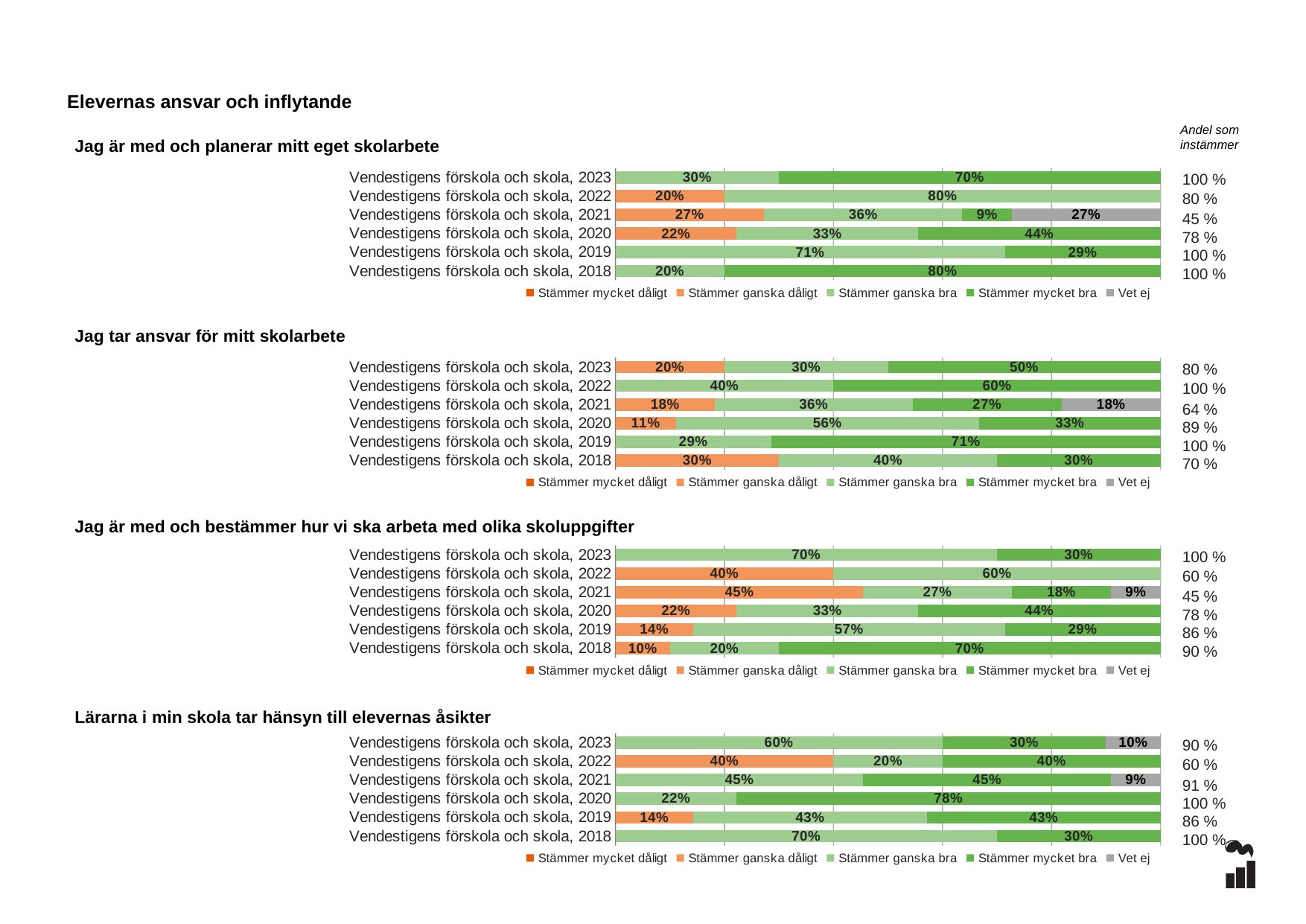
In the chart 'Jag är med och planerar mitt eget skolarbete', what is the 'Vet ej' value for Vendestigens förskola och skola, 2021? 27% In the chart 'Lärarna i min skola tar hänsyn till elevernas åsikter', what is the 'Andel som instämmer' for Vendestigens förskola och skola, 2021? 91 % In the chart 'Jag är med och bestämmer hur vi ska arbeta med olika skoluppgifter', what is the 'Stämmer ganska dåligt' value for Vendestigens förskola och skola, 2021? 45% In the chart 'Lärarna i min skola tar hänsyn till elevernas åsikter', what is the 'Stämmer mycket bra' value for Vendestigens förskola och skola, 2020? 78% In the chart 'Jag är med och bestämmer hur vi ska arbeta med olika skoluppgifter', what is the difference between the 'Stämmer mycket bra' values for 2018 and 2023? 40% In the chart 'Jag är med och planerar mitt eget skolarbete', what is the 'Stämmer mycket bra' value for Vendestigens förskola och skola, 2023? 70% In the chart 'Jag tar ansvar för mitt skolarbete', what is the 'Stämmer ganska bra' value for Vendestigens förskola och skola, 2020? 56% What kind of chart is 'Jag är med och bestämmer hur vi ska arbeta med olika skoluppgifter'? Stacked bar chart How many bars (years) are shown in the chart 'Jag är med och planerar mitt eget skolarbete'? 6 How many series does the legend list for the chart 'Jag tar ansvar för mitt skolarbete'? 5 In the chart 'Lärarna i min skola tar hänsyn till elevernas åsikter', which is larger: the 'Stämmer ganska bra' value for 2023 or for 2022? 2023 In the chart 'Jag tar ansvar för mitt skolarbete', which year has the highest 'Stämmer mycket bra' value? Vendestigens förskola och skola, 2019